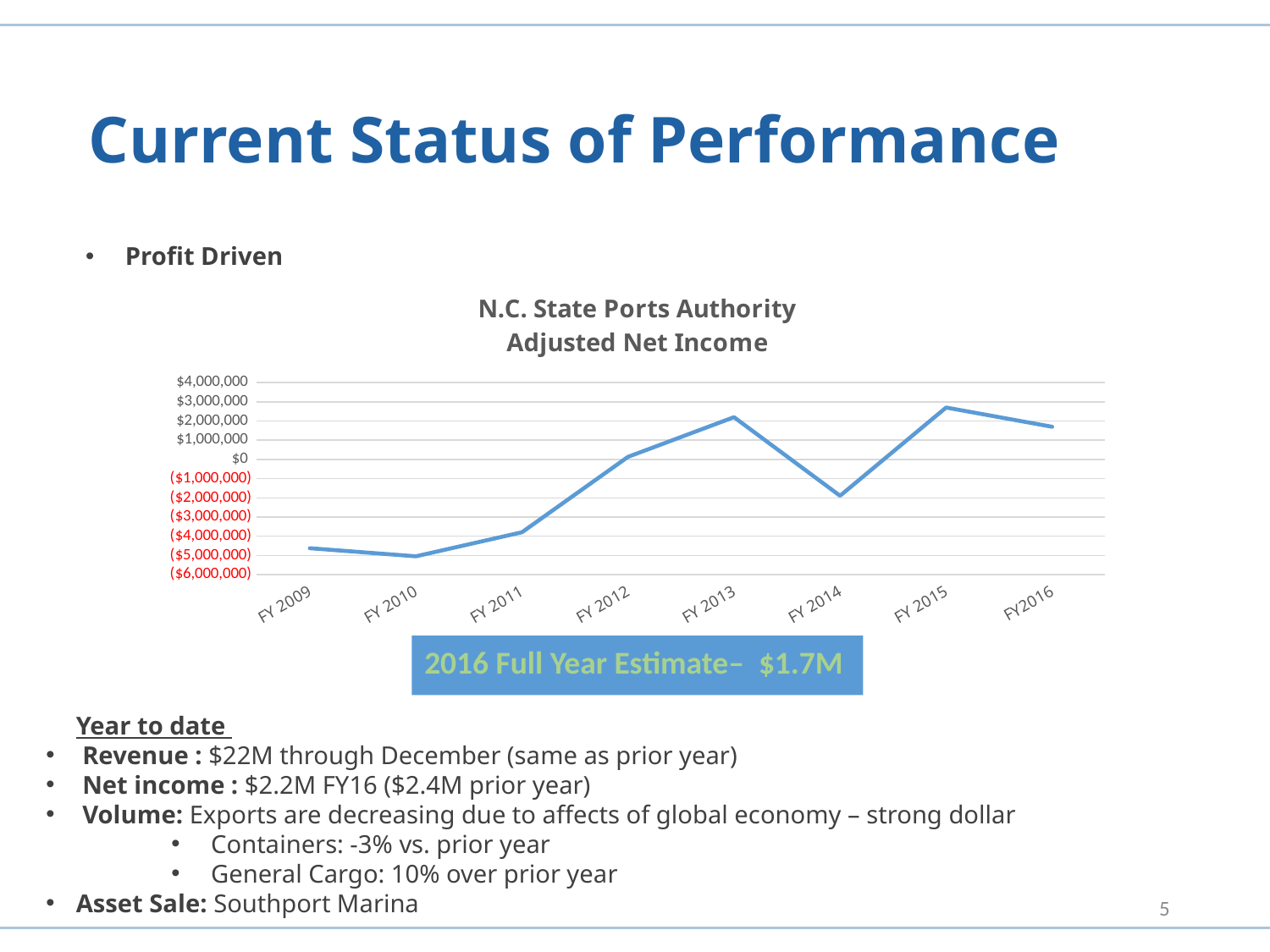
Is the adjusted net income for FY 2011 greater or less than ($3,000,000)? less What kind of chart is shown on the slide? line chart Is the adjusted net income for FY 2013 greater or less than $1,000,000? greater How many fiscal years are plotted on the x axis of the chart? 8 Is the adjusted net income for FY 2014 greater or less than $0? less What is the title of the chart? N.C. State Ports Authority Adjusted Net Income Which fiscal year has the highest adjusted net income in the chart? FY 2015 Which has the larger adjusted net income, FY 2011 or FY 2012? FY 2012 Does the adjusted net income rise or fall from FY 2010 to FY 2013? rise What 2016 full year estimate is shown in the box below the chart? $1.7M Which has the larger adjusted net income, FY 2013 or FY 2014? FY 2013